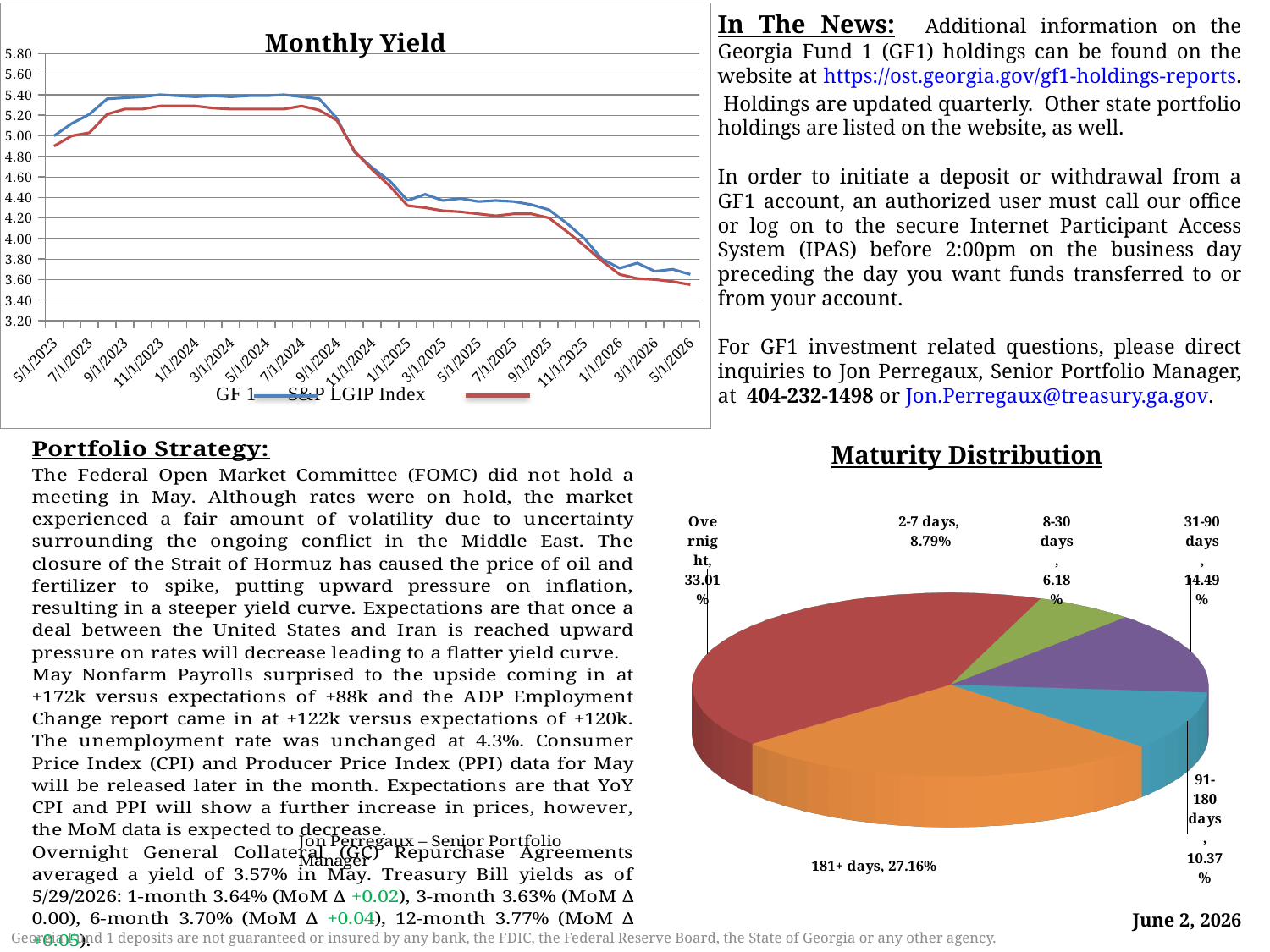
In the Maturity Distribution chart, what is the value for 181+ days? 27.16% In the Maturity Distribution chart, what share is labeled for Overnight? 33.01% In the Maturity Distribution chart, which maturity bucket has the smallest share? 8-30 days In the Monthly Yield chart, is the GF 1 value at 1/1/2024 greater or less than 5.20? greater In the Maturity Distribution chart, which maturity bucket has the largest share? Overnight What kind of chart is the Monthly Yield chart? Line chart In the Monthly Yield chart, do the yields generally rise or fall from 5/1/2023 to 5/1/2026? Fall How many series does the legend of the Monthly Yield chart list? 2 In the Maturity Distribution chart, how many slices does the pie have? 6 In the Maturity Distribution chart, what is the value for 31-90 days? 14.49% In the Maturity Distribution chart, what is the difference between the Overnight share and the 181+ days share? 5.85% In the Maturity Distribution chart, which is larger, 2-7 days or 91-180 days? 91-180 days